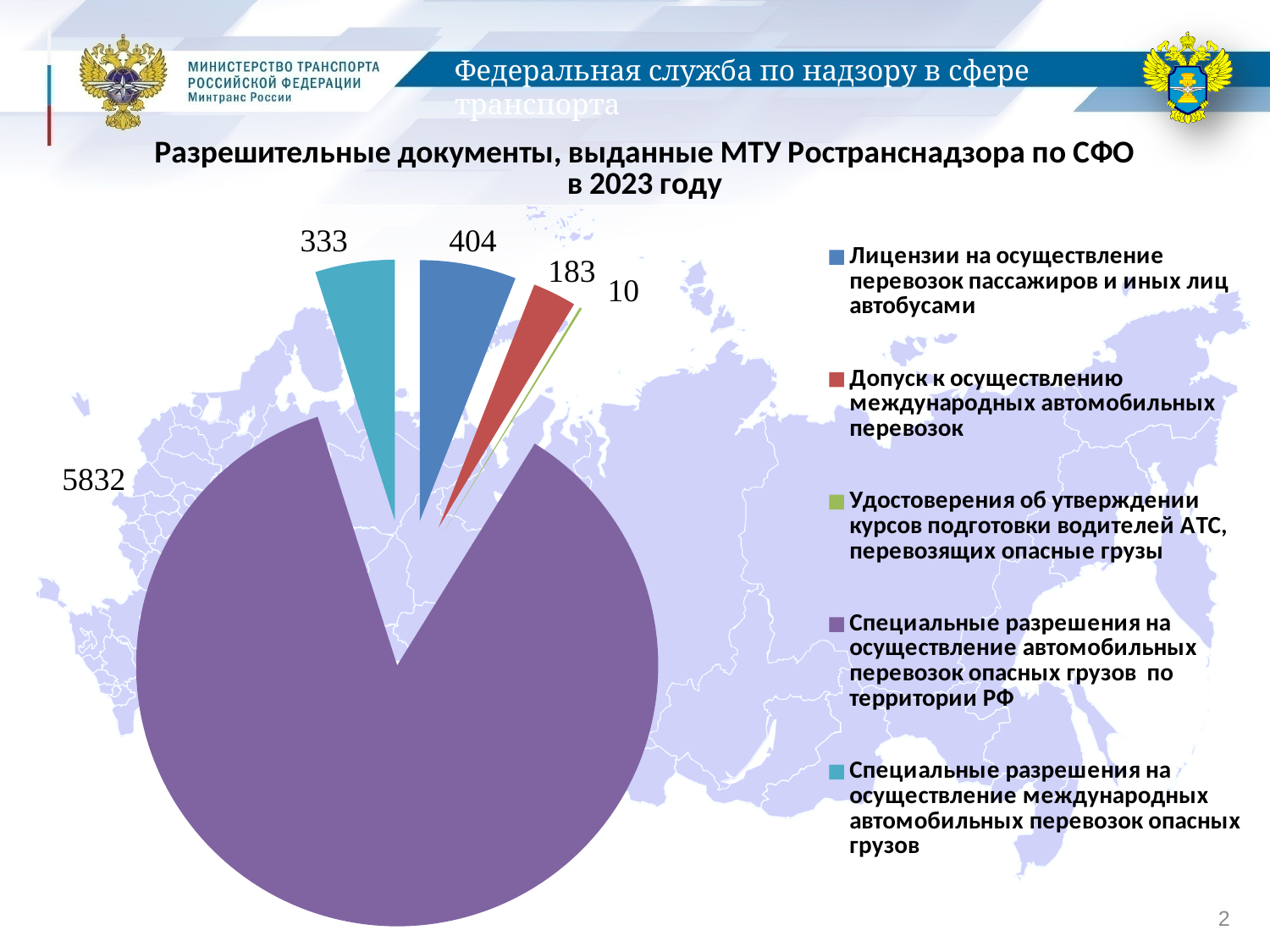
How many slices does the pie chart have? 5 Which category has the largest slice of the pie? Специальные разрешения на осуществление автомобильных перевозок опасных грузов по территории РФ What is the difference between the value for "Лицензии на осуществление перевозок пассажиров и иных лиц автобусами" (404) and "Специальные разрешения на осуществление международных автомобильных перевозок опасных грузов" (333)? 71 What is the value for "Специальные разрешения на осуществление международных автомобильных перевозок опасных грузов"? 333 What is the value for "Удостоверения об утверждении курсов подготовки водителей АТС, перевозящих опасные грузы"? 10 What is the title of the chart on the slide? Разрешительные документы, выданные МТУ Ространснадзора по СФО в 2023 году Which is larger: the value for "Допуск к осуществлению международных автомобильных перевозок" or the value for "Специальные разрешения на осуществление международных автомобильных перевозок опасных грузов"? Специальные разрешения на осуществление международных автомобильных перевозок опасных грузов What kind of chart is shown on the slide? pie chart What is the value for "Лицензии на осуществление перевозок пассажиров и иных лиц автобусами"? 404 What is the value for "Допуск к осуществлению международных автомобильных перевозок"? 183 Which category has the smallest slice of the pie? Удостоверения об утверждении курсов подготовки водителей АТС, перевозящих опасные грузы How many entries does the legend of the pie chart list? 5